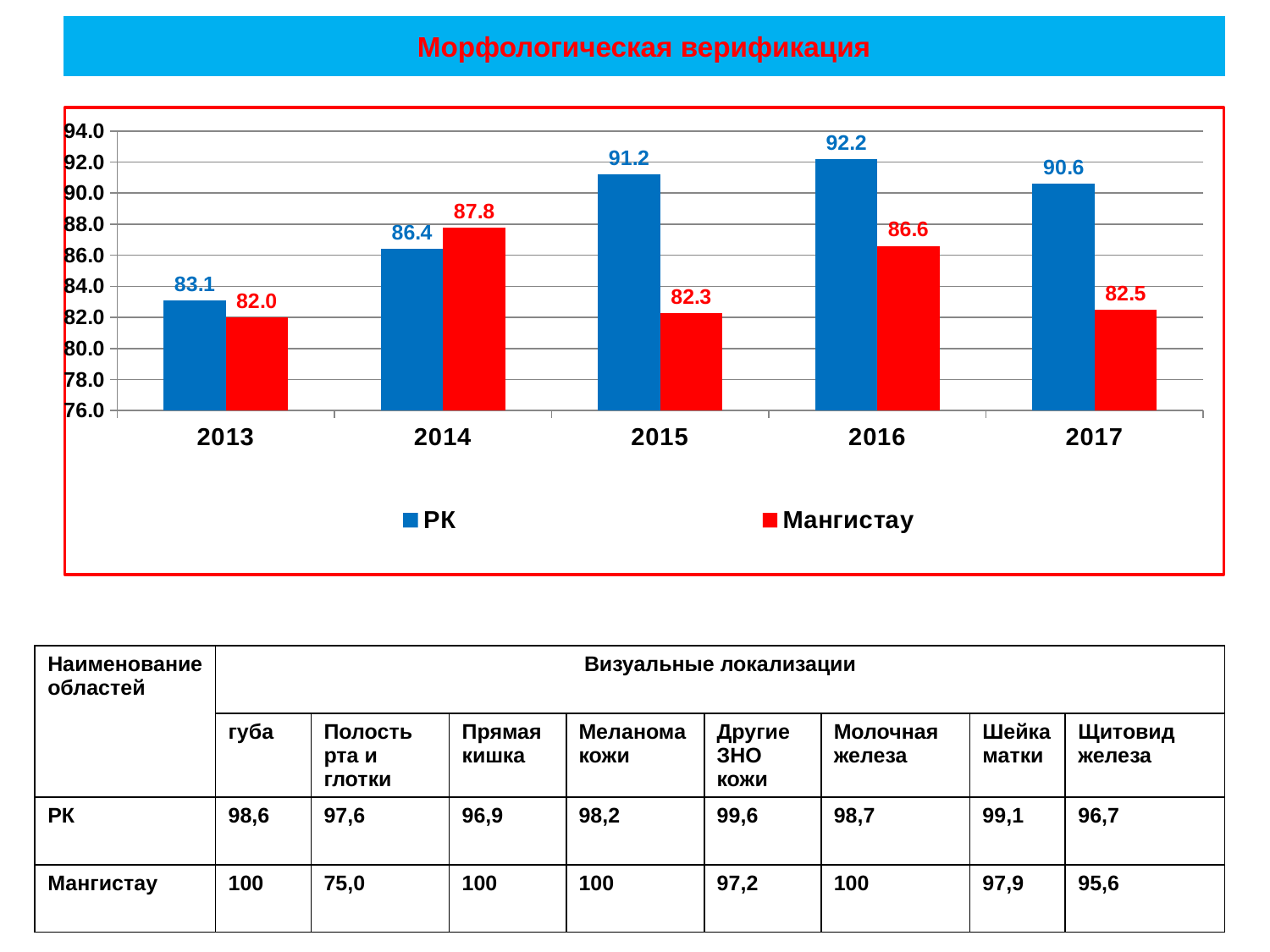
What is the value for РК in 2016? 92.2 What kind of chart is shown? bar chart How many years are shown on the x axis? 5 What is the value for Мангистау in 2014? 87.8 In which year is the РК value highest? 2016 In which year is the Мангистау value lowest? 2013 How many series does the legend list? 2 Which is larger in 2014, РК or Мангистау? Мангистау Is the value for РК in 2013 greater or less than 84.0? less What is the difference between РК and Мангистау in 2015? 8.9 Which colour represents Мангистау in the chart? red What is the value for Мангистау in 2017? 82.5